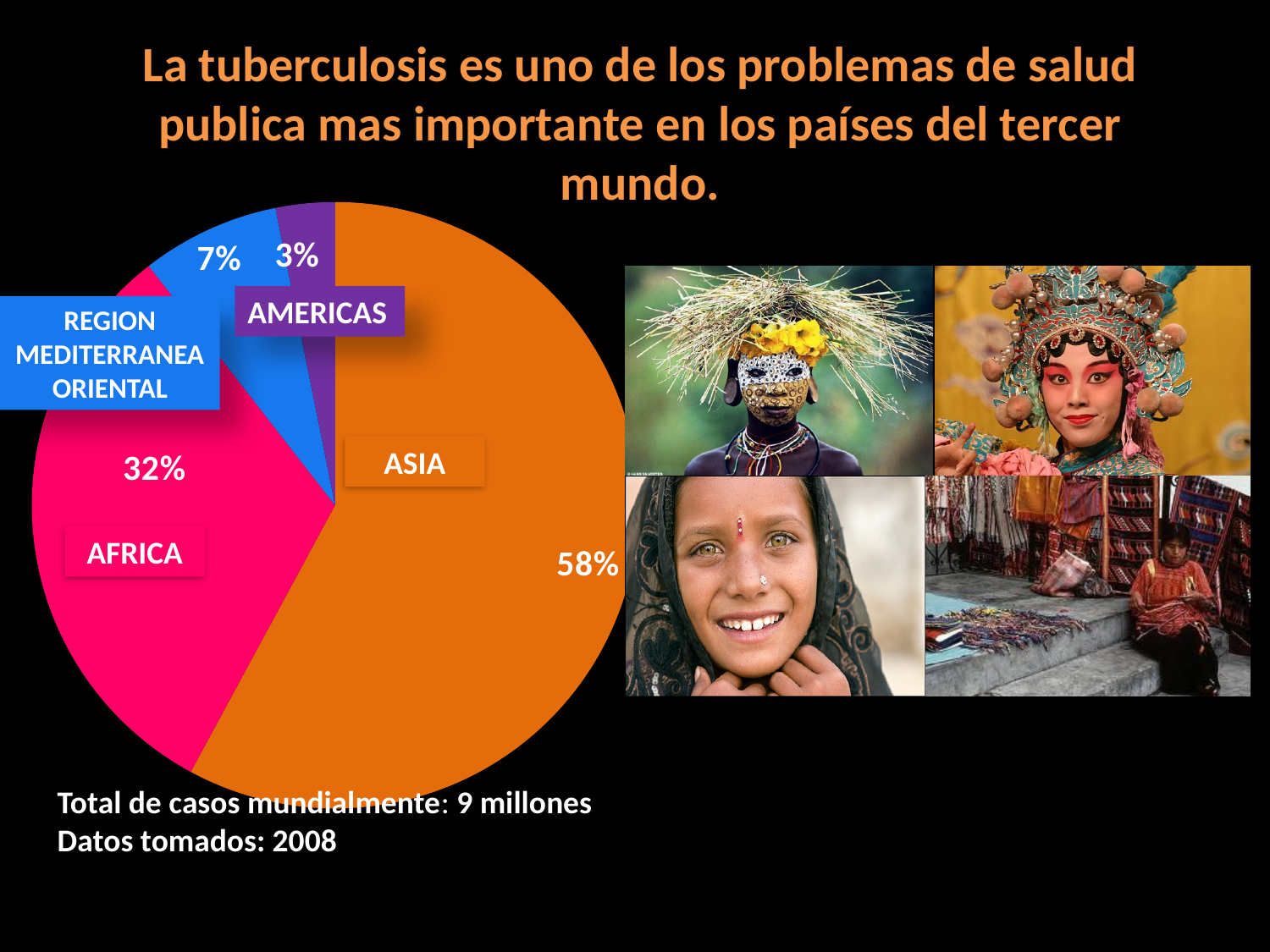
What percentage of the pie chart corresponds to AMERICAS? 3% What colour is the ASIA slice of the pie chart? orange What percentage of the pie chart corresponds to REGION MEDITERRANEA ORIENTAL? 7% Which region has the smallest slice of the pie chart? AMERICAS What percentage of the pie chart corresponds to AFRICA? 32% What percentage of the pie chart corresponds to ASIA? 58% What kind of chart is shown on the slide? pie chart Which region has the largest slice of the pie chart? ASIA How many slices does the pie chart have? 4 Which slice is larger, REGION MEDITERRANEA ORIENTAL or AMERICAS? REGION MEDITERRANEA ORIENTAL What is the combined share of the AFRICA and ASIA slices? 90% What is the difference in percentage points between the ASIA slice and the AFRICA slice? 26